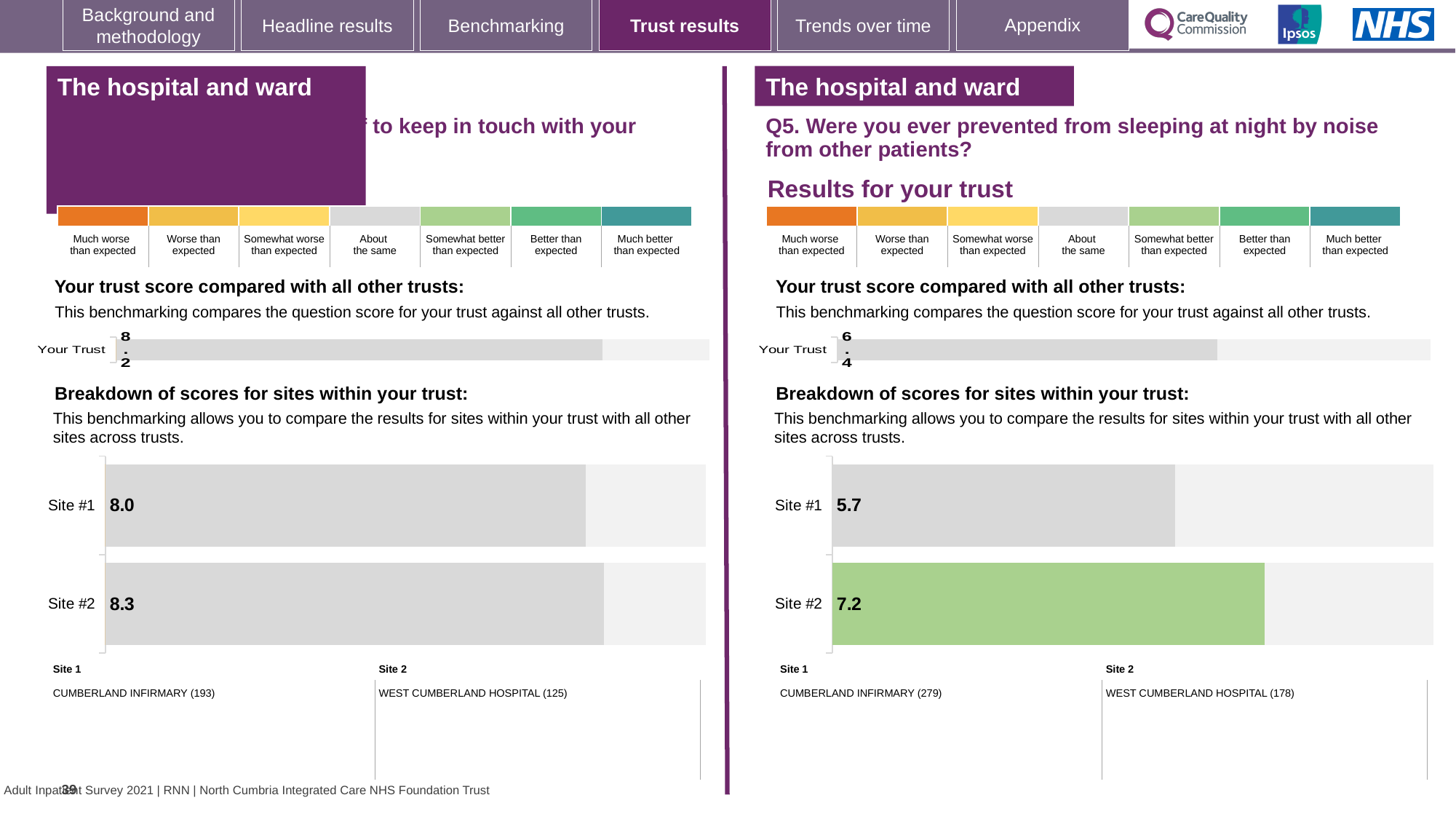
On the left-hand slide, what is the 'Your Trust' score shown in the trust score comparison chart? 8.2 On the left-hand slide, what is the difference between the Site #2 score and the Site #1 score? 0.3 On the left-hand slide, which site has the lower score in the breakdown of scores for sites? Site #1 On the right-hand slide (Q5), how many sites are shown in the breakdown of scores for sites chart? 2 On the right-hand slide (Q5), what is the difference between the Site #2 score and the Site #1 score? 1.5 On the left-hand slide, what is the score for Site #1 in the breakdown of scores for sites? 8.0 On the right-hand slide (Q5, prevented from sleeping by noise from other patients), what is the score for Site #1 in the breakdown of scores for sites? 5.7 On the right-hand slide (Q5), what is the score for Site #2 in the breakdown of scores for sites? 7.2 On the right-hand slide (Q5), what is the 'Your Trust' score shown in the trust score comparison chart? 6.4 On the left-hand slide, what is the score for Site #2 in the breakdown of scores for sites? 8.3 What type of chart is used for the breakdown of scores for sites on the right-hand slide? Bar chart On the right-hand slide (Q5), which site has the higher score in the breakdown of scores for sites? Site #2